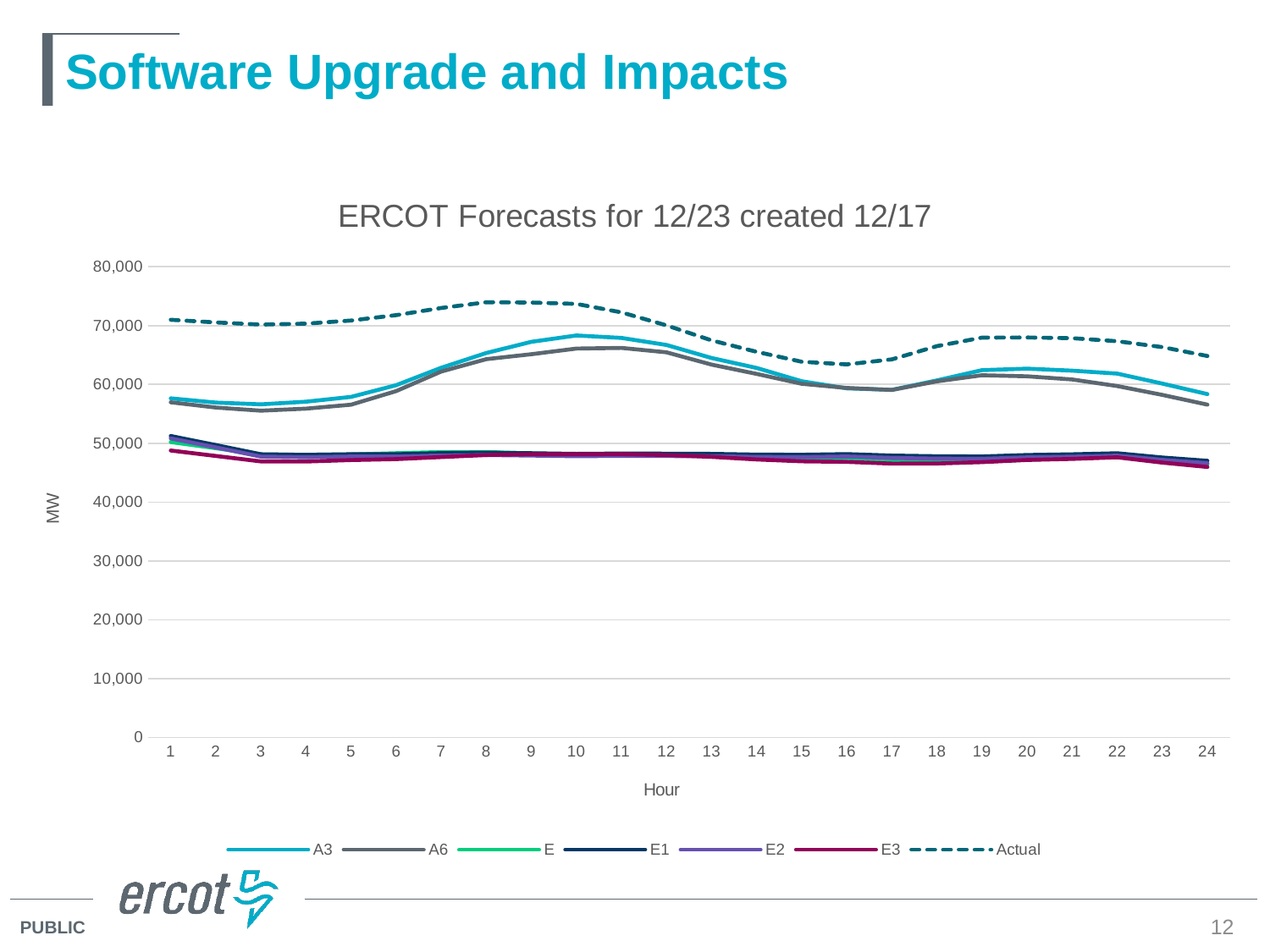
Is the Actual value at hour 10 greater or less than 70,000? greater Is the A6 value at hour 24 greater or less than 60,000? less What is the title of the chart? ERCOT Forecasts for 12/23 created 12/17 How many hours are plotted along the x axis? 24 What is the label on the y axis? MW Is the E3 value at hour 3 greater or less than 50,000? less At hour 1, which is larger, the A3 value or the E3 value? A3 How many series does the legend list? 7 At hour 12, which series has the highest value? Actual Does the Actual series rise or fall from hour 10 to hour 16? fall What kind of chart is shown on the slide? line chart